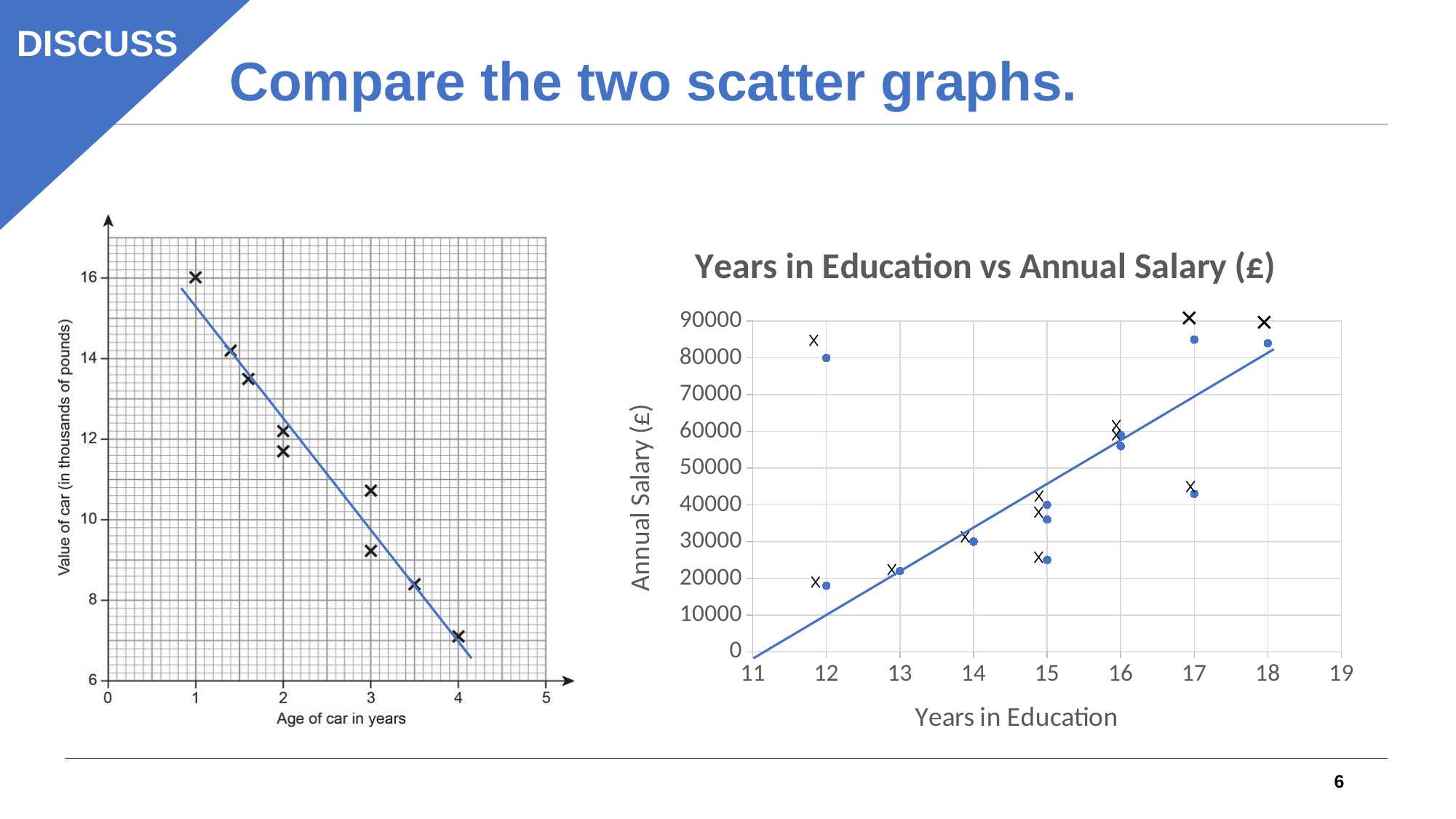
In the left chart, is the value for the car aged 4 years greater or less than 8? less In the 'Years in Education vs Annual Salary (£)' chart, is the salary for 13 years in education greater or less than 30000? less In the left chart, what is the value of the car (in thousands of pounds) for the car aged 1 year? 16 In the 'Years in Education vs Annual Salary (£)' chart, is the salary for 18 years in education greater or less than 80000? greater What kind of chart is the 'Years in Education vs Annual Salary (£)' chart? scatter chart In the left chart, does the value of the car rise or fall as the age of the car increases? fall What is the x-axis label of the left chart? Age of car in years How many data points are plotted on the left chart (Age of car in years)? 9 In the left chart, which age of car has the highest value? 1 year In the 'Years in Education vs Annual Salary (£)' chart, does the line of best fit rise or fall as years in education increase? rise What is the title of the right chart? Years in Education vs Annual Salary (£) What kind of chart is the left chart (Age of car in years)? scatter chart